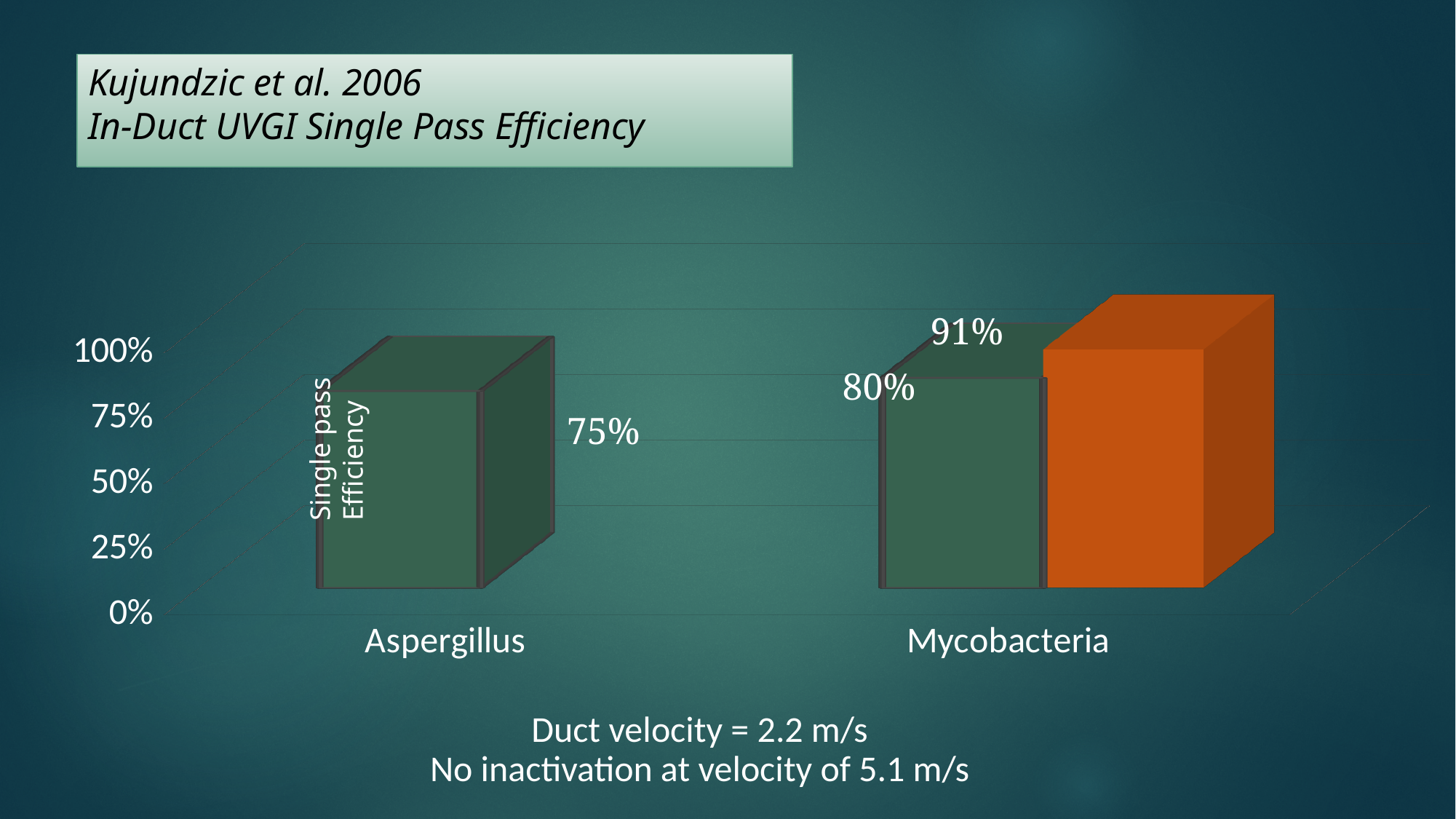
Is the value for Aspergillus greater or less than 50%? greater Which category has the lowest single pass efficiency value? Aspergillus What is the difference between the two Mycobacteria bars, 91% and 80%? 11 percentage points What is the difference between the orange Mycobacteria bar (91%) and the Aspergillus bar (75%)? 16 percentage points Which is larger: the Aspergillus value or the green Mycobacteria value? the green Mycobacteria value What kind of chart is shown on the slide? bar chart What value is labelled on the green bar for Mycobacteria? 80% Which category has the highest single pass efficiency value? Mycobacteria How many categories are shown on the x axis of the chart? 2 What is the label on the vertical axis of the chart? Single pass Efficiency What is the single pass efficiency value shown for Aspergillus? 75% What value is labelled on the orange bar for Mycobacteria? 91%